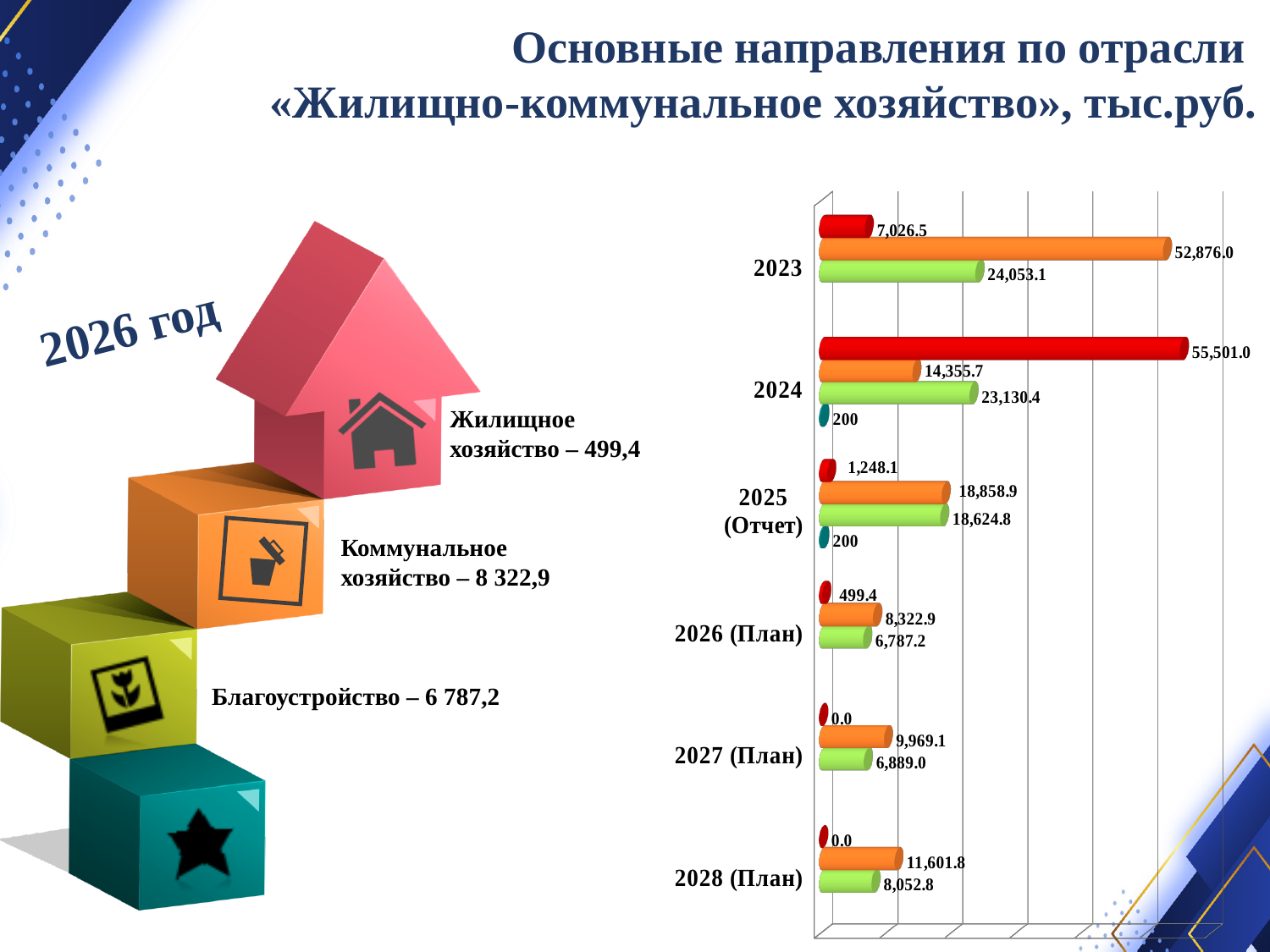
Does the green bar rise or fall from 2026 (План) to 2028 (План)? rise What is the value of the green bar for 2025 (Отчет)? 18,624.8 In which year does the red bar reach its highest value? 2024 What type of chart is shown on the right side of the slide? bar chart What is the value of the red bar for 2027 (План)? 0.0 What is the difference between the orange bar and the green bar for 2026 (План)? 1,535.7 In which year does the orange bar reach its highest value? 2023 What is the value of the orange bar for 2023? 52,876.0 What is the value of the orange bar for 2028 (План)? 11,601.8 What is the value of the red bar for 2024? 55,501.0 How many year categories are shown on the chart's vertical axis? 6 For 2025 (Отчет), which is larger: the orange bar or the green bar? the orange bar